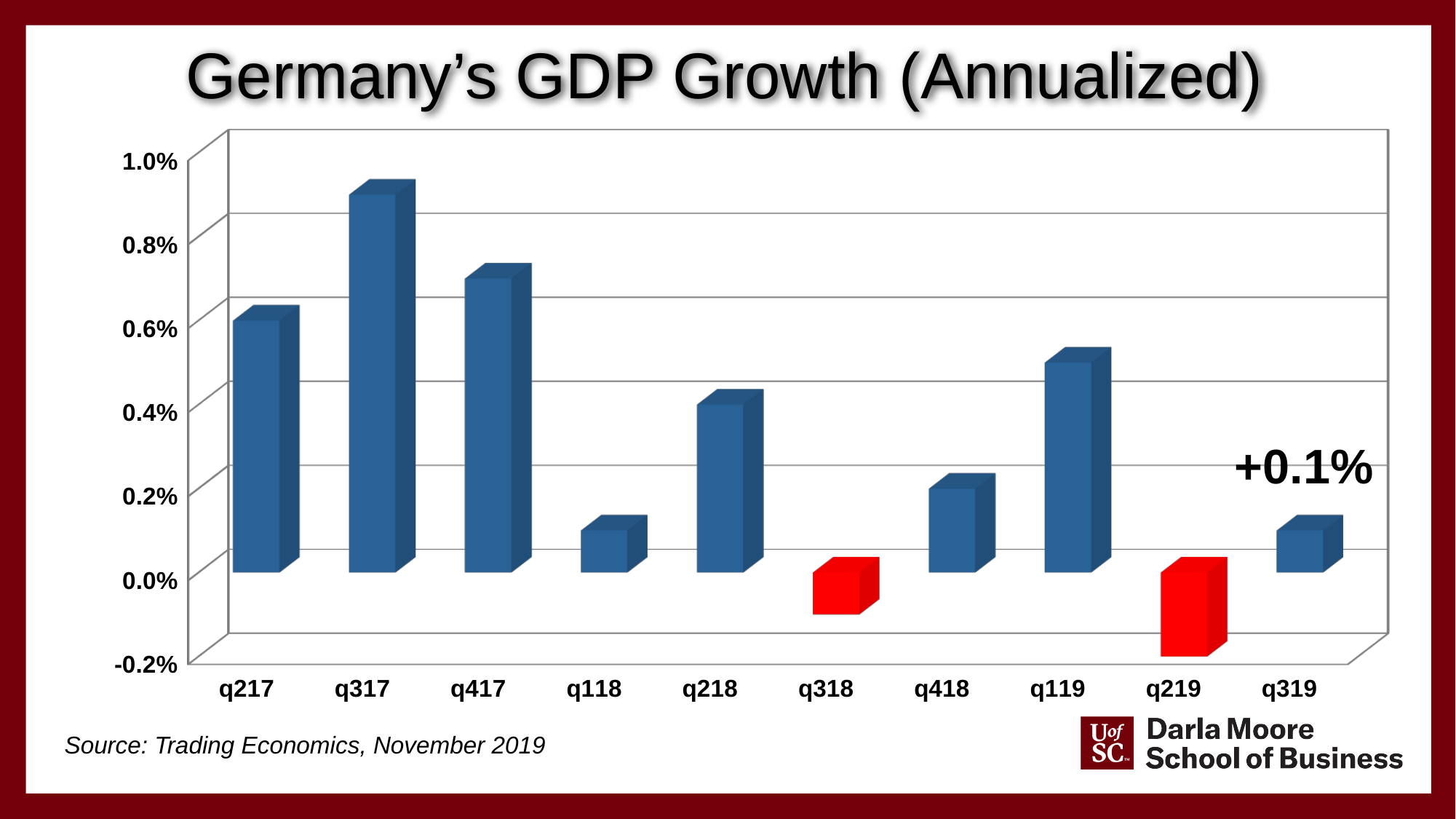
What kind of chart is shown on the slide? bar chart Is the value for q118 greater or less than 0.2%? less Which quarter has the lowest GDP growth? q219 Which is larger, the value for q218 or the value for q418? q218 Is the value for q217 greater or less than 0.4%? greater Which quarters are shown with red bars? q318 and q219 Which is larger, the value for q317 or the value for q417? q317 How many quarters are shown on the chart? 10 Do the values rise or fall from q317 to q118? fall What is the value shown for q319? +0.1% Is the value for q119 greater or less than 0.4%? greater Which quarter has the highest GDP growth? q317